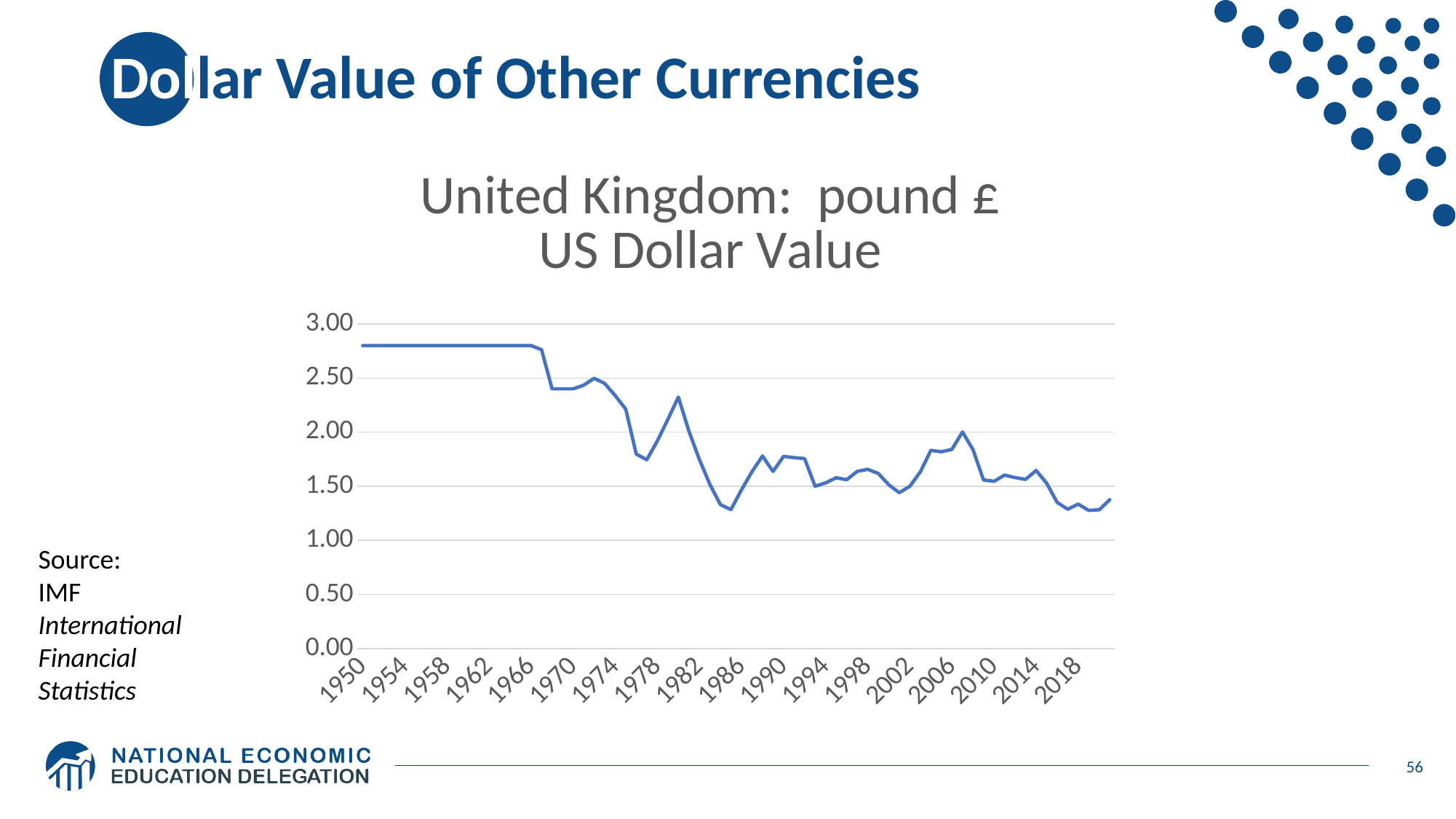
What kind of chart is shown on the slide? line chart Is the value for 1970 greater or less than 2.50? less Is the value for 1990 greater or less than 1.50? greater Is the value for 1950 greater or less than 2.50? greater What is the title of the chart? United Kingdom: pound £ US Dollar Value What is the highest value shown on the vertical axis? 3.00 Which is larger, the value for 1950 or the value for 2018? 1950 Which is larger, the value for 1970 or the value for 1986? 1970 Overall, does the US dollar value of the pound rise or fall from 1950 to 2018? fall